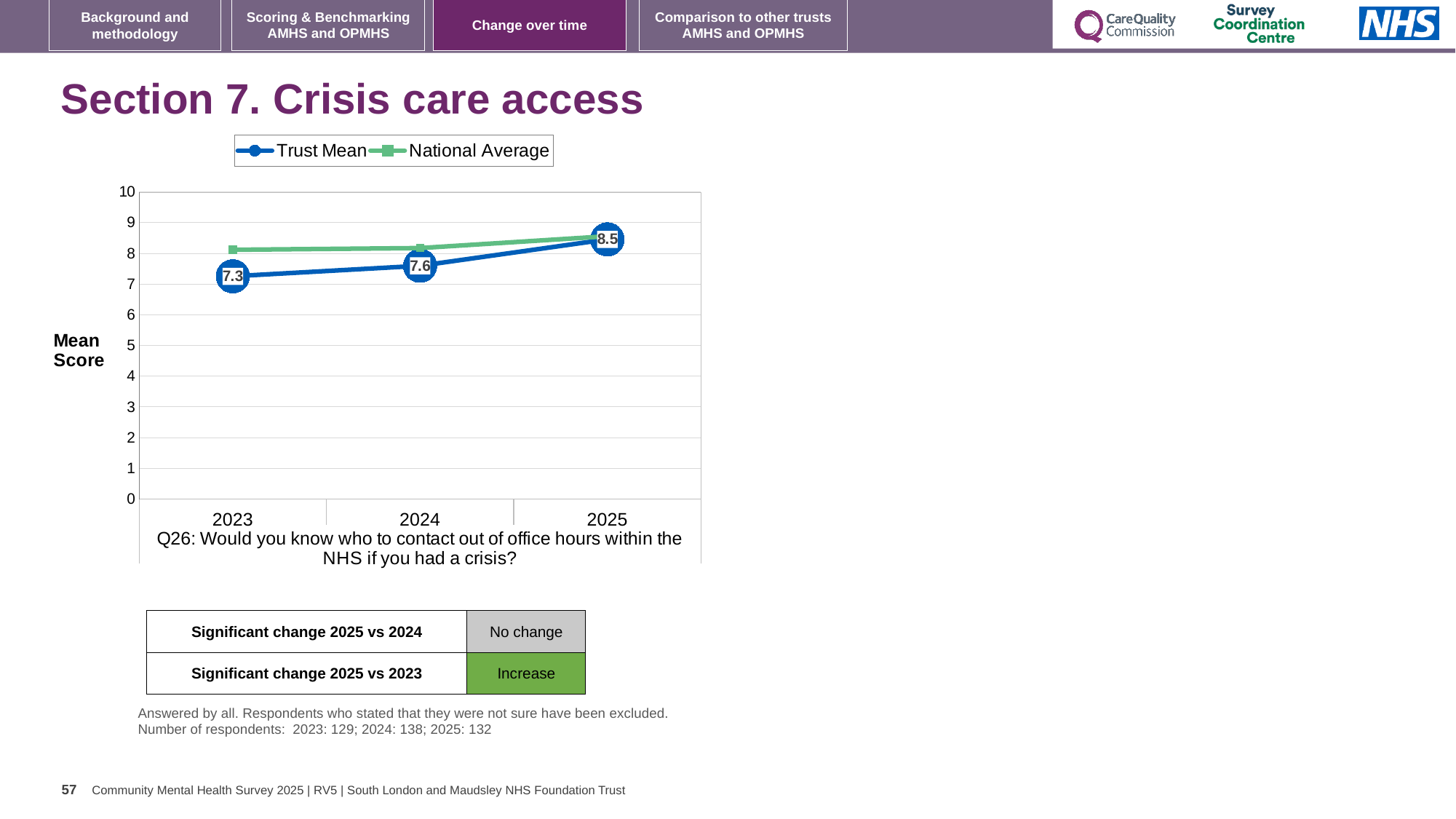
In 2023, which is higher: the Trust Mean or the National Average? National Average What is the Trust Mean score for 2025? 8.5 What is the Trust Mean score for 2024? 7.6 Is the National Average value for 2025 greater or less than 8? greater In which year is the Trust Mean score highest? 2025 In which year is the Trust Mean score lowest? 2023 Does the Trust Mean rise or fall from 2023 to 2025? rise By how much did the Trust Mean score change from 2023 to 2025? 1.2 How many series does the legend list? 2 What is the difference between the Trust Mean scores for 2025 and 2024? 0.9 What kind of chart is shown on the slide? line chart What is the Trust Mean score for 2023? 7.3